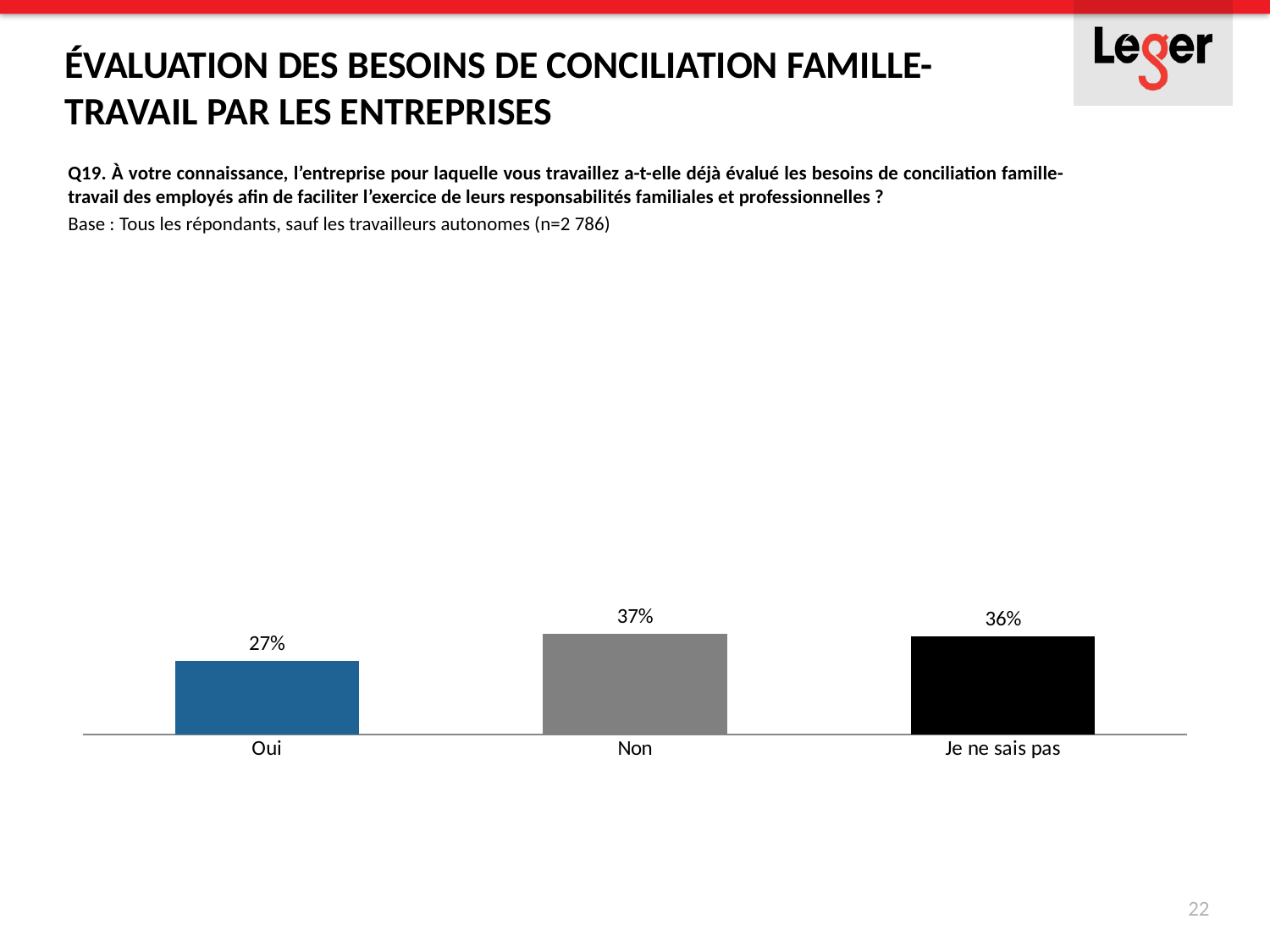
What kind of chart is shown on the slide? Bar chart How many categories are shown in the chart? 3 What is the value for Non? 37% What is the base size (n) stated for the chart? n=2 786 What is the difference between the values for Je ne sais pas and Oui? 9% Which category has the lowest value? Oui Which is larger, the value for Oui or the value for Je ne sais pas? Je ne sais pas What is the value for Oui? 27% What colour is the bar for Oui? Blue What is the difference between the values for Non and Oui? 10% What is the value for Je ne sais pas? 36% Which category has the highest value? Non